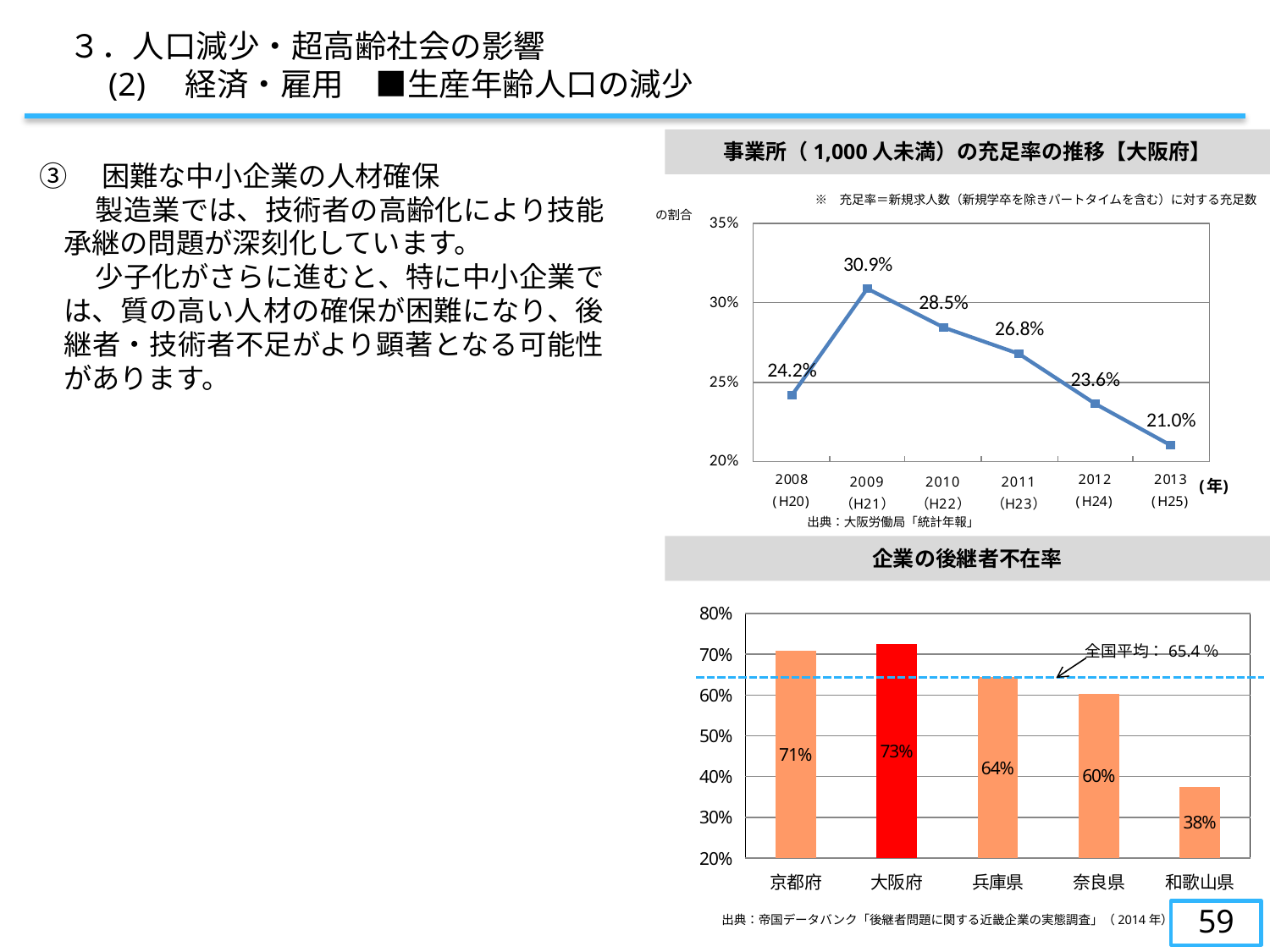
In the top chart (事業所（1,000人未満）の充足率の推移【大阪府】), how many years are plotted? 6 In the top chart (事業所（1,000人未満）の充足率の推移【大阪府】), do the values rise or fall from 2009 to 2013? fall In the bottom chart (企業の後継者不在率), what is the value for 大阪府? 73% In the top chart (事業所（1,000人未満）の充足率の推移【大阪府】), what is the difference between the 2009 value and the 2013 value? 9.9 percentage points In the top chart (事業所（1,000人未満）の充足率の推移【大阪府】), what is the value for 2009 (H21)? 30.9% In the bottom chart (企業の後継者不在率), which prefecture has the lowest value? 和歌山県 In the bottom chart (企業の後継者不在率), which is larger, the value for 京都府 or the value for 兵庫県? 京都府 In the top chart (事業所（1,000人未満）の充足率の推移【大阪府】), which year has the lowest value? 2013 (H25) In the bottom chart (企業の後継者不在率), what is the national average (全国平均) shown by the dashed line? 65.4% In the top chart (事業所（1,000人未満）の充足率の推移【大阪府】), what is the value for 2013 (H25)? 21.0% What kind of chart is the top chart (事業所（1,000人未満）の充足率の推移【大阪府】)? line chart In the top chart (事業所（1,000人未満）の充足率の推移【大阪府】), which year has the highest value? 2009 (H21)